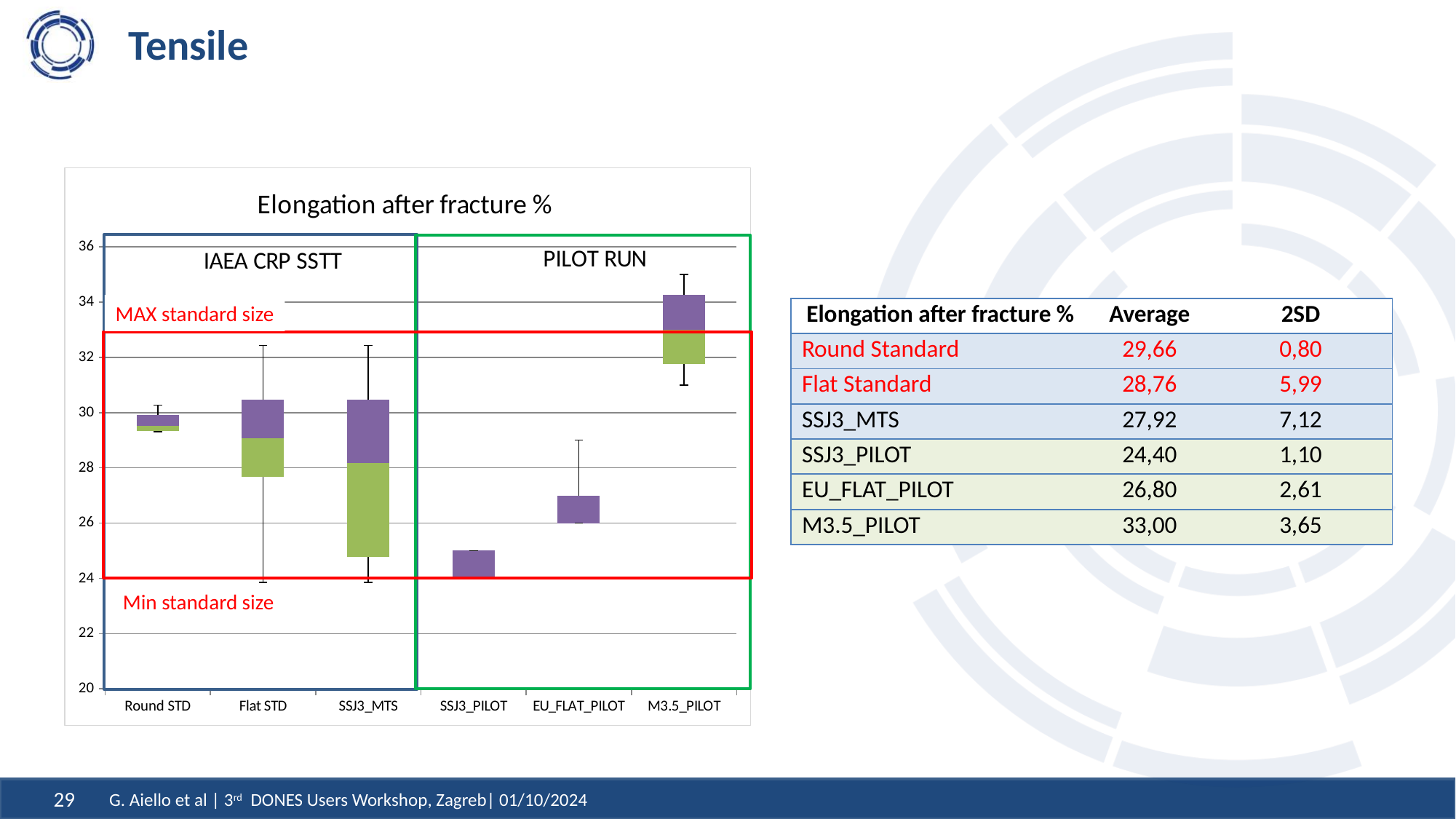
Is the box for M3.5_PILOT above or below 30 on the y axis? above How many categories are plotted along the x axis of the chart? 6 What kind of chart is shown on the slide? Box plot (box-and-whisker chart) Is the box for SSJ3_PILOT greater or less than 26? less Is the box for EU_FLAT_PILOT greater or less than 28? less Which box is positioned higher on the chart, M3.5_PILOT or EU_FLAT_PILOT? M3.5_PILOT What is the title of the chart? Elongation after fracture % Which category has the highest box in the chart? M3.5_PILOT Which category has the lowest box in the chart? SSJ3_PILOT What is the lowest value shown on the y axis of the chart? 20 Which box is positioned higher on the chart, Round STD or SSJ3_PILOT? Round STD What are the two group labels written inside the chart area above the boxes? IAEA CRP SSTT and PILOT RUN